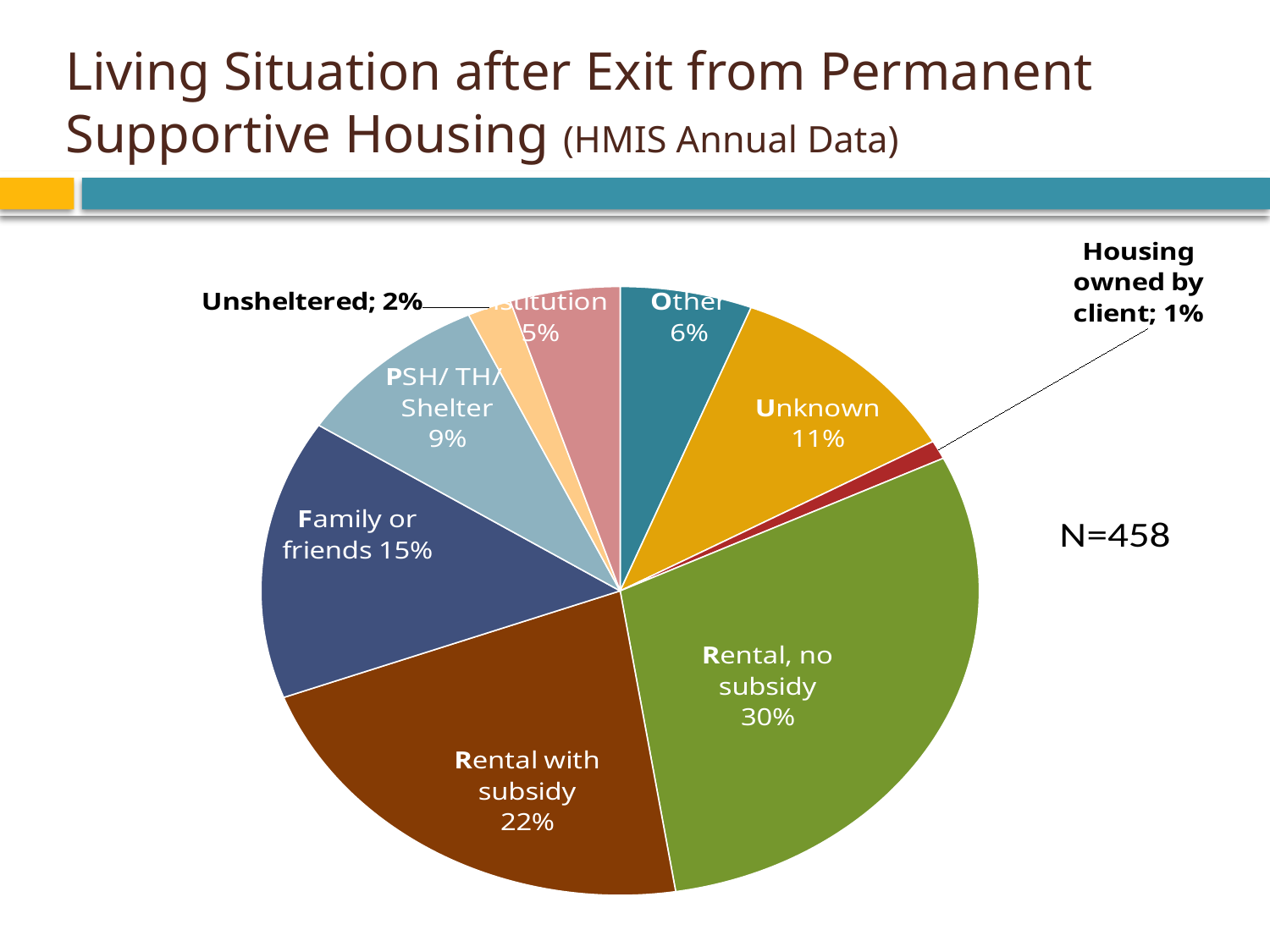
What is the difference in percentage points between "Rental, no subsidy" and "Rental with subsidy"? 8 What is the value of N shown next to the pie chart? 458 Which is larger, the share for "Unknown" or the share for "Other"? Unknown What kind of chart is shown on the slide? pie chart What share of the pie is "Rental, no subsidy"? 30% What percentage is shown for "Unknown"? 11% Which category has the smallest slice of the pie? Housing owned by client What share of the pie is "Rental with subsidy"? 22% What percentage is shown for "PSH/ TH/ Shelter"? 9% Which category has the largest slice of the pie? Rental, no subsidy What percentage is shown for "Unsheltered"? 2% What percentage is shown for "Family or friends"? 15%